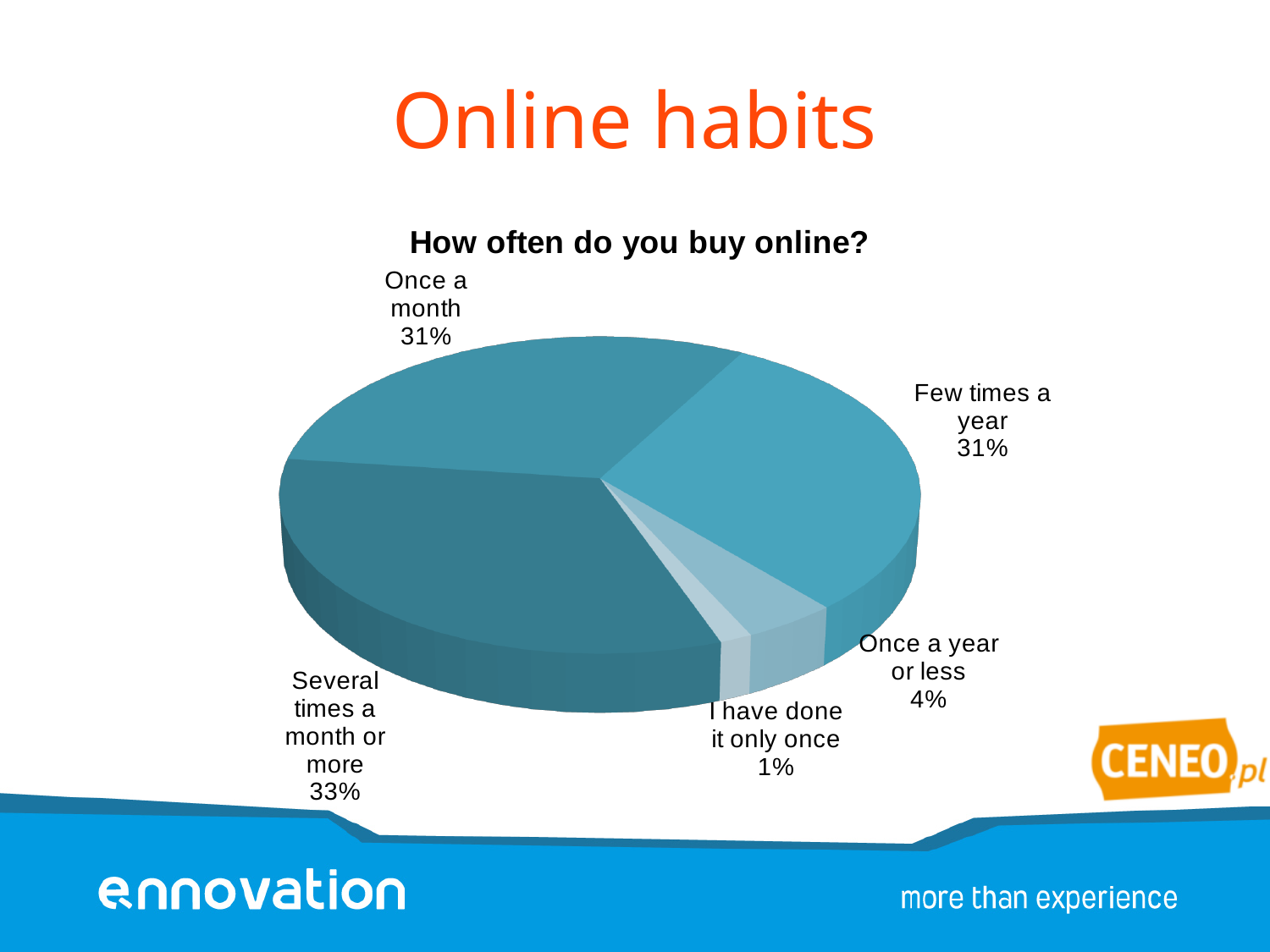
Which category has the smallest share of the pie? I have done it only once What type of chart is shown on the slide? Pie chart What percentage of respondents buy online several times a month or more? 33% How many categories are shown in the pie chart? 5 What percentage of respondents buy online once a year or less? 4% What percentage of respondents buy online once a month? 31% What is the title of the chart? How often do you buy online? What is the difference in percentage points between 'Several times a month or more' and 'Once a year or less'? 29 Which category has the largest share of the pie? Several times a month or more Which is larger: the share for 'Once a year or less' or the share for 'I have done it only once'? Once a year or less What percentage of respondents have bought online only once? 1% What percentage of respondents buy online a few times a year? 31%